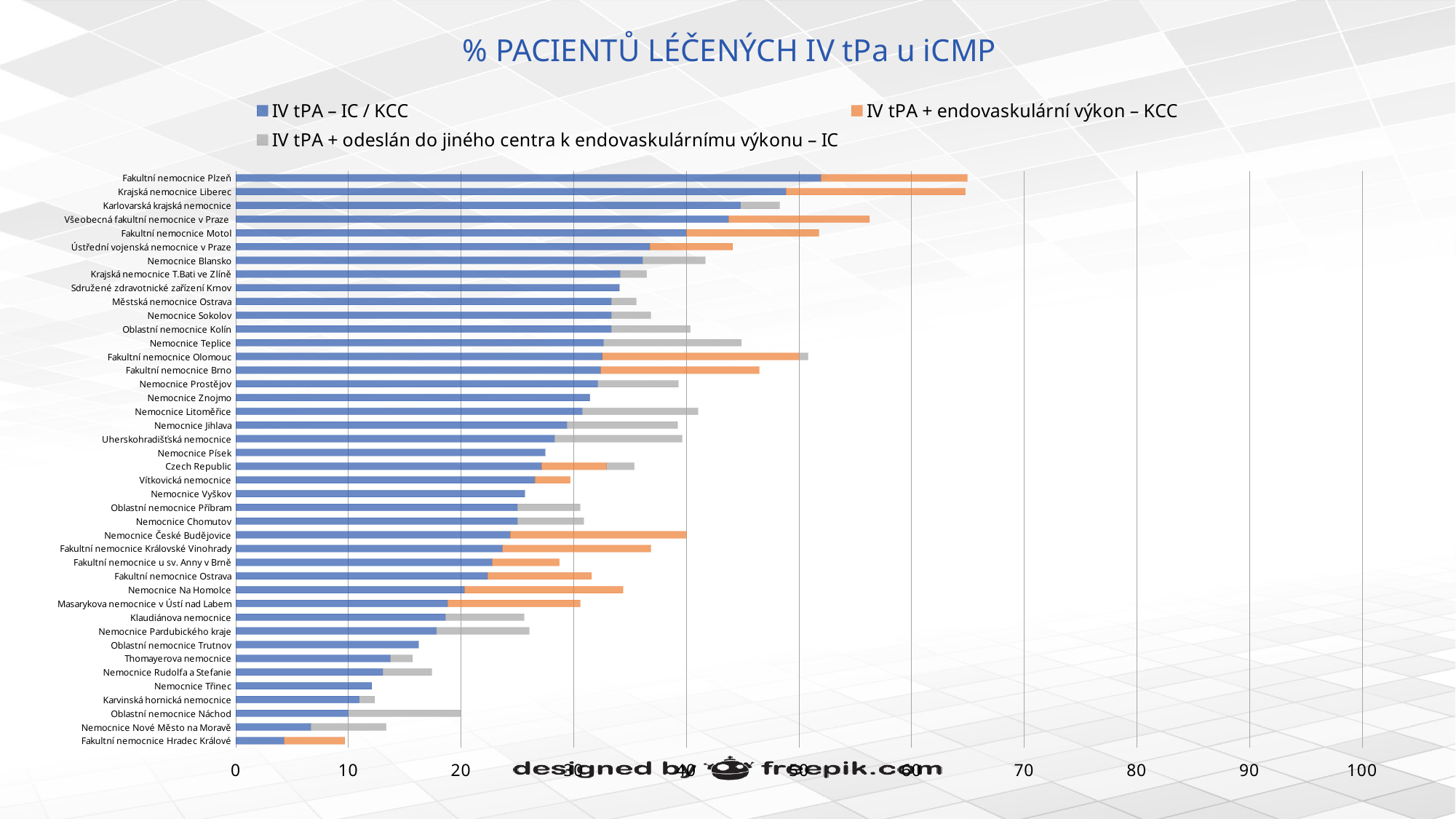
Which hospital has the highest value for IV tPA – IC / KCC? Fakultní nemocnice Plzeň Which has the larger IV tPA – IC / KCC value, Fakultní nemocnice Plzeň or Fakultní nemocnice Motol? Fakultní nemocnice Plzeň Is the IV tPA – IC / KCC value for Fakultní nemocnice Hradec Králové greater or less than 10? less What is the title of the chart? % PACIENTŮ LÉČENÝCH IV tPa u iCMP Is the total stacked bar for Krajská nemocnice Liberec greater or less than 60? greater What kind of chart is shown on the slide? bar chart Which series is shown in orange? IV tPA + endovaskulární výkon – KCC How many hospitals/categories are listed on the chart? 42 Is the IV tPA – IC / KCC value for Fakultní nemocnice Plzeň greater or less than 50? greater Which hospital has the lowest value for IV tPA – IC / KCC? Fakultní nemocnice Hradec Králové How many series does the legend list? 3 Which has the larger IV tPA – IC / KCC value, Nemocnice Třinec or Nemocnice Blansko? Nemocnice Blansko